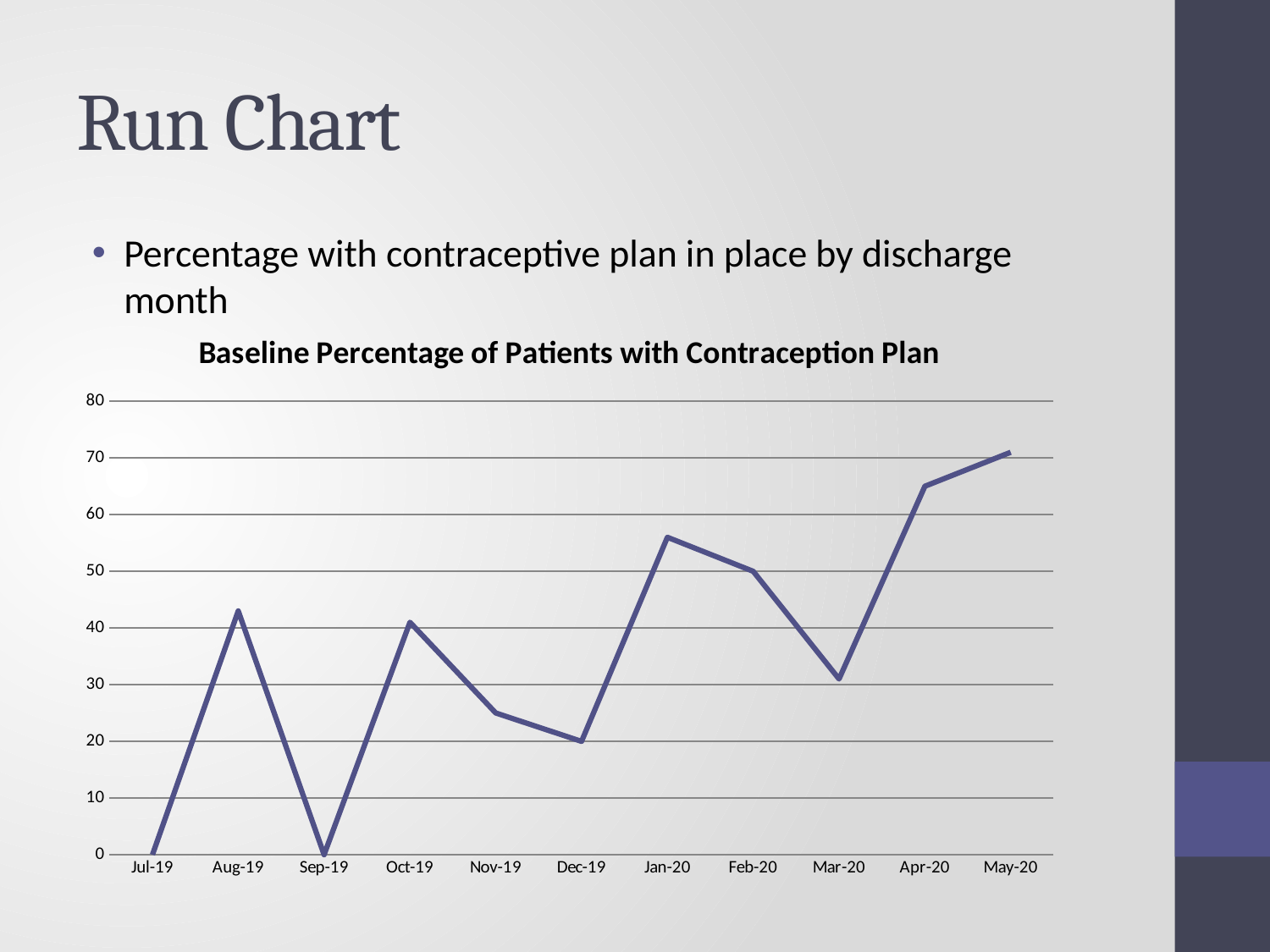
What is the value for Jul-19? 0 Is the value for Aug-19 greater or less than 40? greater Is the value for Nov-19 greater or less than 30? less What is the value for Feb-20? 50 What is the value for Dec-19? 20 What is the value for Sep-19? 0 Overall, do the values rise or fall from Jul-19 to May-20? Rise Which is larger, the value for Jan-20 or the value for Feb-20? Jan-20 What is the title of the chart? Baseline Percentage of Patients with Contraception Plan Which month has the highest value? May-20 How many months are plotted on the x axis of the chart? 11 What type of chart is shown on the slide? Line chart